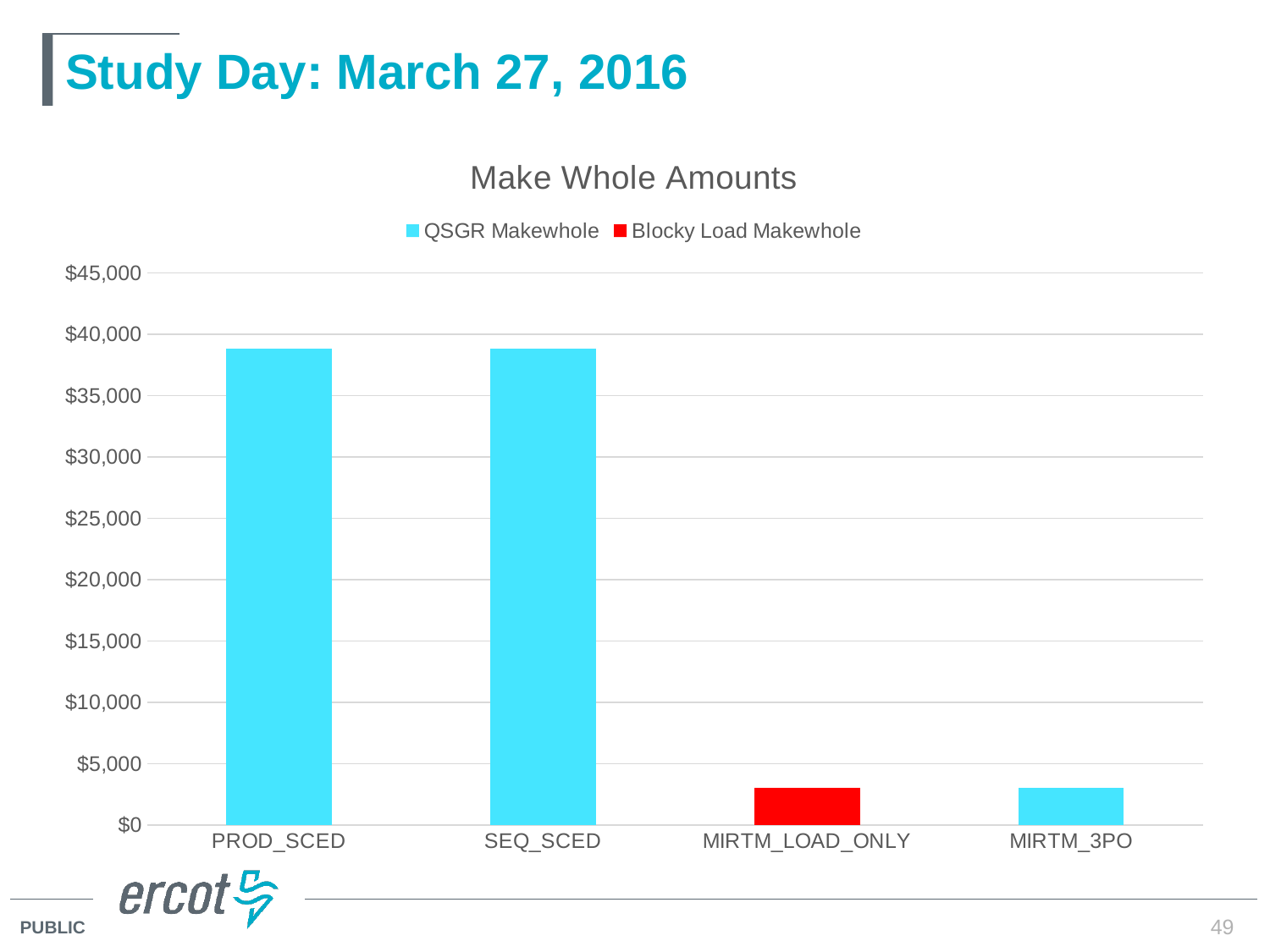
Is the value for MIRTM_LOAD_ONLY greater or less than $5,000? less Is the value for PROD_SCED greater or less than $35,000? greater What kind of chart is shown on the slide? bar chart Which category is plotted in the Blocky Load Makewhole series (red)? MIRTM_LOAD_ONLY Is the value for SEQ_SCED greater or less than $40,000? less How many series does the legend list? 2 Which is larger, the value for PROD_SCED or the value for MIRTM_3PO? PROD_SCED What is the title of the chart? Make Whole Amounts Which is larger, the value for SEQ_SCED or the value for MIRTM_LOAD_ONLY? SEQ_SCED How many categories are shown on the x axis? 4